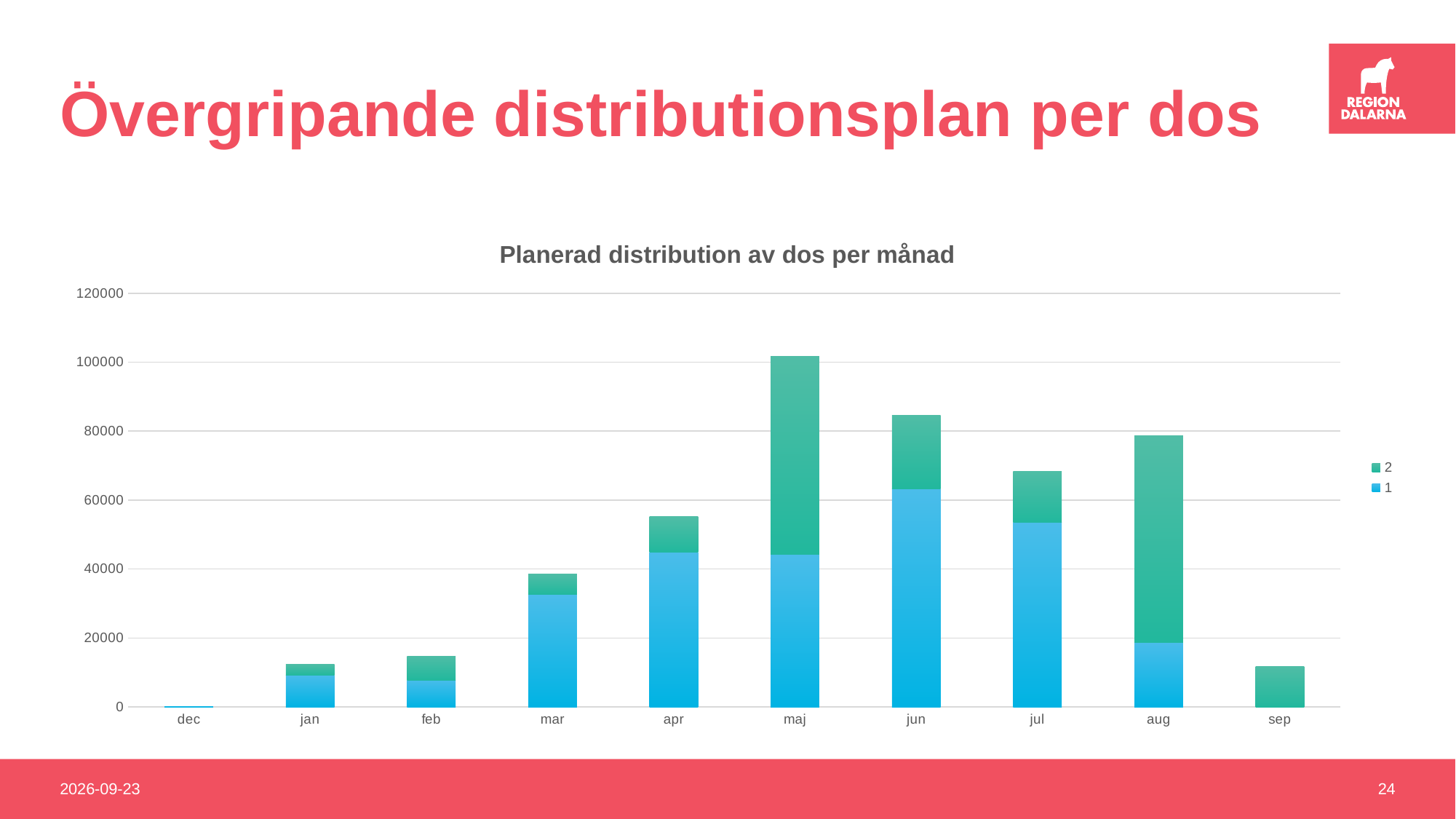
Is the total for maj greater or less than 100000? greater Which month has the lowest total planned distribution? dec What is the title of the chart? Planerad distribution av dos per månad What kind of chart is shown on the slide? Stacked bar chart Is the total for jul greater or less than 60000? greater How many months are shown on the x axis? 10 Is the total for sep greater or less than 20000? less How many series does the legend list? 2 Do the total values rise or fall from dec to maj? rise Which month has the highest total planned distribution? maj Which month has the larger value for series 2, aug or jun? aug Which month has the larger total, maj or jun? maj